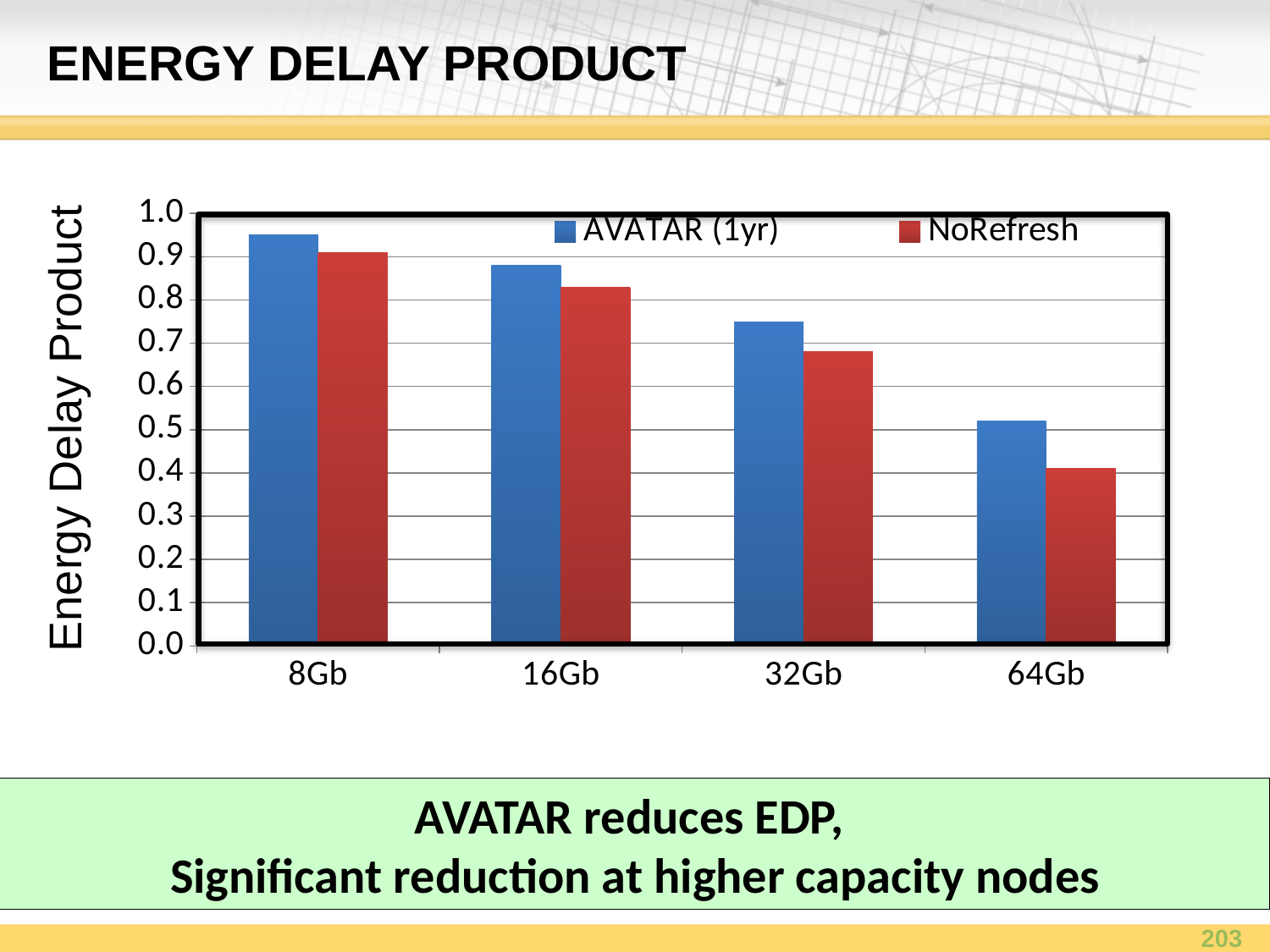
At 64Gb, which series has the larger value, AVATAR (1yr) or NoRefresh? AVATAR (1yr) What kind of chart is shown on the slide? bar chart Which category has the lowest NoRefresh value? 64Gb How many capacity categories are shown on the x axis? 4 Is the NoRefresh value for 64Gb greater or less than 0.5? less Is the NoRefresh value for 32Gb greater or less than 0.7? less How many series does the legend list? 2 Which colour represents the NoRefresh series? red Is the AVATAR (1yr) value for 8Gb greater or less than 0.9? greater What is the label of the y axis? Energy Delay Product Which category has the highest AVATAR (1yr) value? 8Gb Do the NoRefresh values rise or fall as capacity increases from 8Gb to 64Gb? fall